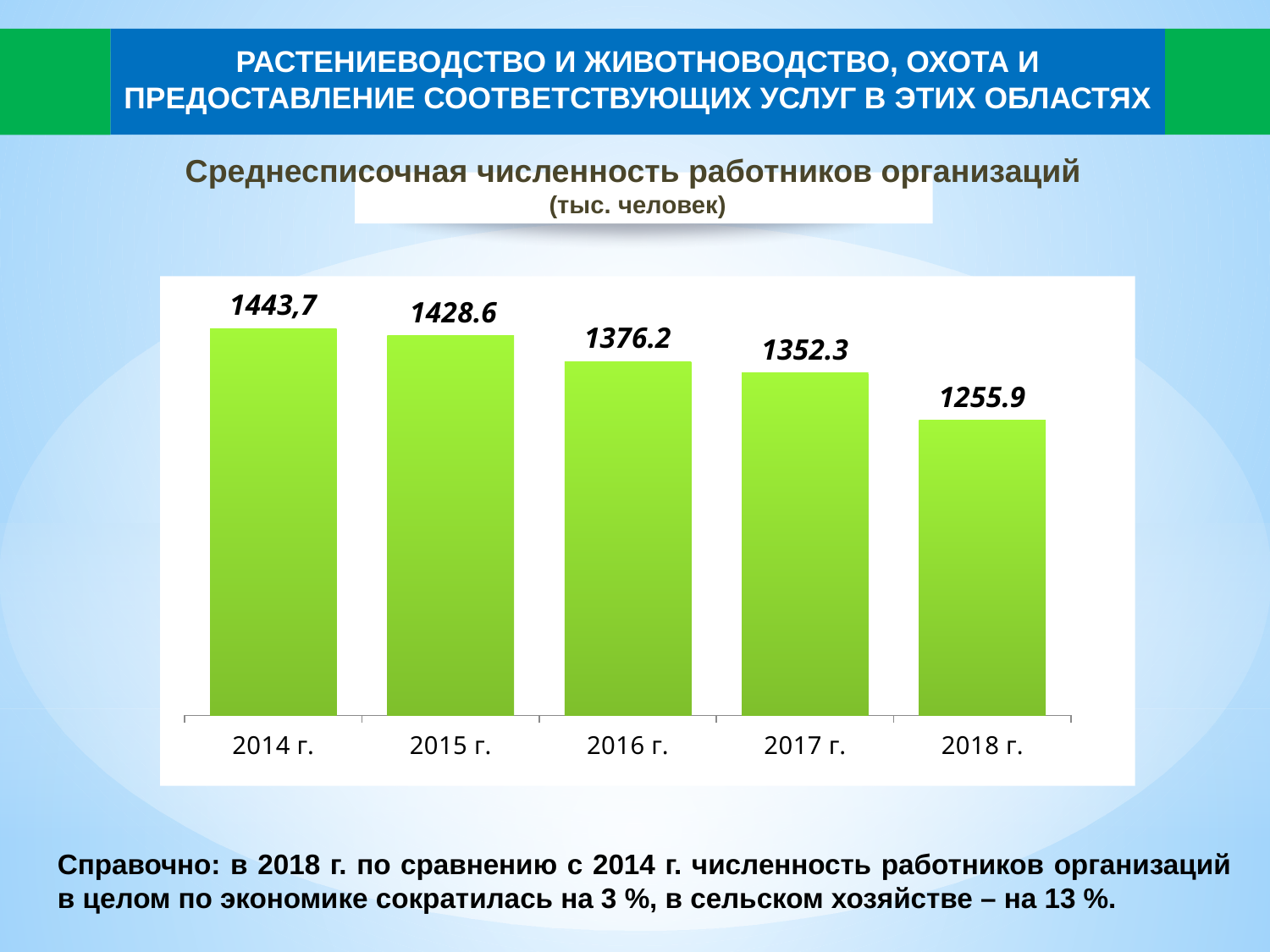
What is the value for 2018 г.? 1255.9 What is the value for 2014 г.? 1443,7 What is the value for 2017 г.? 1352.3 What is the difference between the values for 2017 г. and 2018 г.? 96.4 What is the difference between the values for 2015 г. and 2016 г.? 52.4 How many years are shown on the chart? 5 Which is larger, the value for 2015 г. or the value for 2017 г.? 2015 г. Which year has the lowest value? 2018 г. Which year has the highest value? 2014 г. What is the value for 2016 г.? 1376.2 What kind of chart is this? bar chart Do the values rise or fall from 2014 г. to 2018 г.? fall